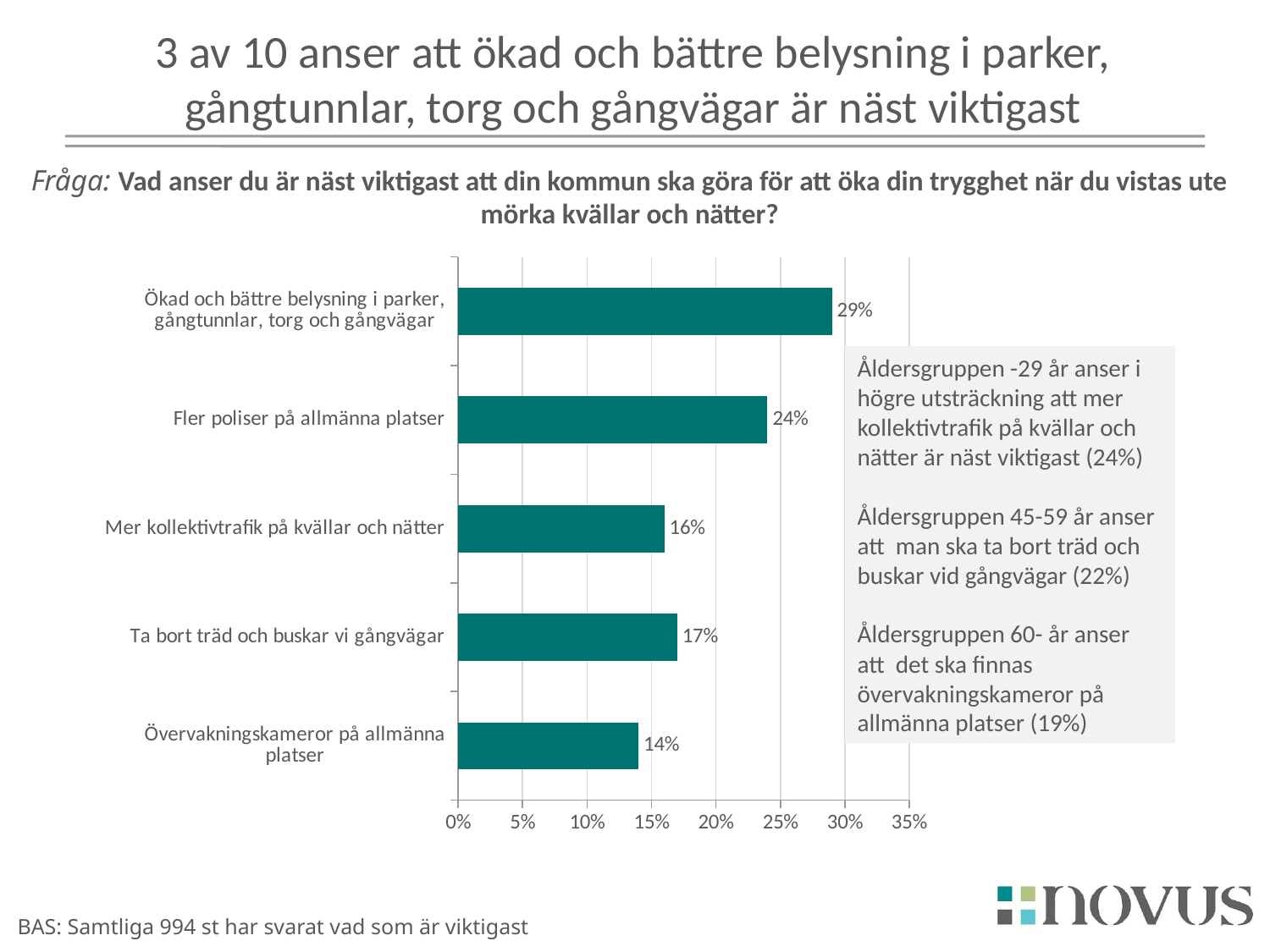
What is the difference between the values for "Ökad och bättre belysning i parker, gångtunnlar, torg och gångvägar" and "Fler poliser på allmänna platser"? 5% What kind of chart is shown on the slide? bar chart Is the value for "Fler poliser på allmänna platser" greater or less than 20%? greater Which category has the highest value? Ökad och bättre belysning i parker, gångtunnlar, torg och gångvägar What is the value for "Övervakningskameror på allmänna platser"? 14% What is the highest value shown on the x axis of the chart? 35% How many categories are shown in the chart? 5 What is the value for "Mer kollektivtrafik på kvällar och nätter"? 16% Which is larger, the value for "Ta bort träd och buskar vi gångvägar" or "Mer kollektivtrafik på kvällar och nätter"? Ta bort träd och buskar vi gångvägar What is the value for "Fler poliser på allmänna platser"? 24% Which category has the lowest value? Övervakningskameror på allmänna platser What is the difference between the values for "Ta bort träd och buskar vi gångvägar" and "Övervakningskameror på allmänna platser"? 3%